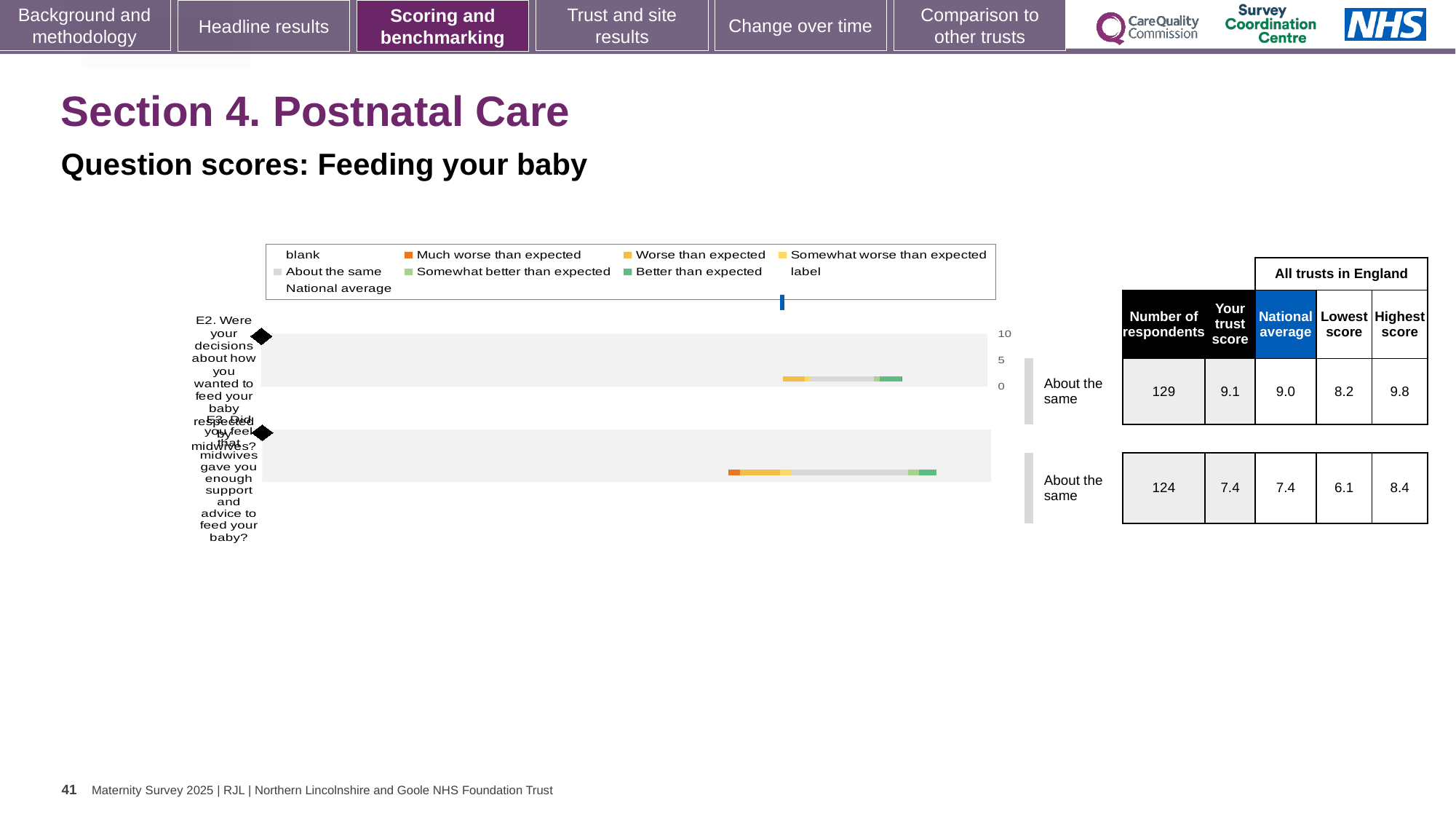
What kind of chart is used to show the question scores on this slide? Bar chart What benchmark category is shown for question E2? About the same Which question has the higher 'Your trust score', E2 or E3? E2 What is the difference between the highest score and the lowest score for question E2? 1.6 How many questions are plotted in the chart? 2 What is the national average for question E3 (midwives gave you enough support and advice to feed your baby)? 7.4 How many respondents answered question E2? 129 What is the 'Your trust score' for question E2 (decisions about how you wanted to feed your baby respected by midwives)? 9.1 What is the lowest score among all trusts in England for question E3? 6.1 Which question has more respondents, E2 or E3? E2 What is the highest score among all trusts in England for question E3? 8.4 What is the subtitle describing the chart on this slide? Question scores: Feeding your baby